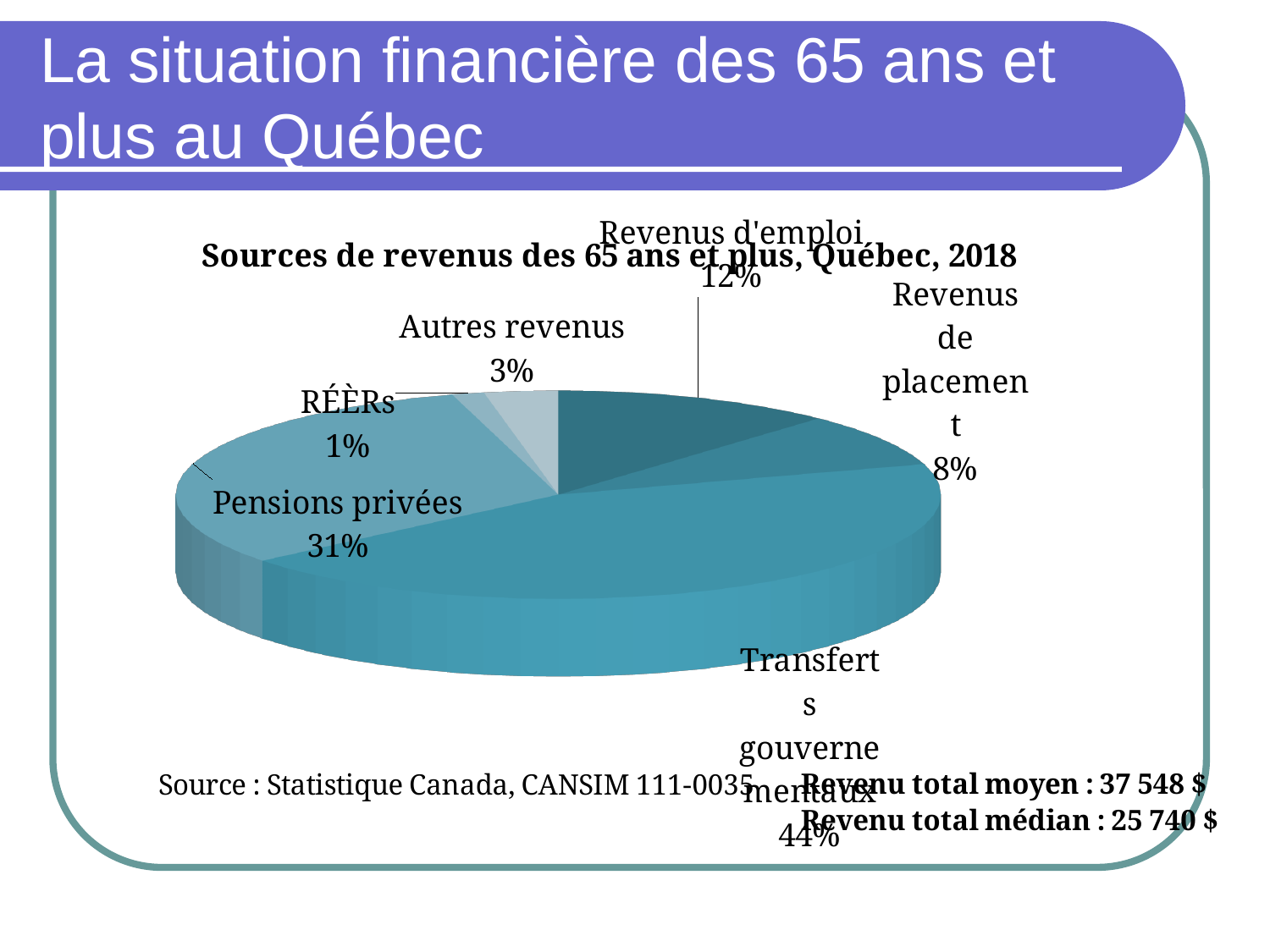
What share of the pie is Pensions privées? 31% What share of the pie is RÉÈRs? 1% Which income source has the smallest share of the pie? RÉÈRs What kind of chart is shown on the slide? Pie chart How many slices does the pie chart have? 6 Which income source has the largest share of the pie? Transferts gouvernementaux What share of the pie is Revenus de placement? 8% What share of the pie is Revenus d'emploi? 12% What share of the pie is Transferts gouvernementaux? 44% What is the title of the chart? Sources de revenus des 65 ans et plus, Québec, 2018 Which is larger, the share for Revenus d'emploi or the share for Revenus de placement? Revenus d'emploi What is the difference in percentage points between Transferts gouvernementaux and Pensions privées? 13 percentage points